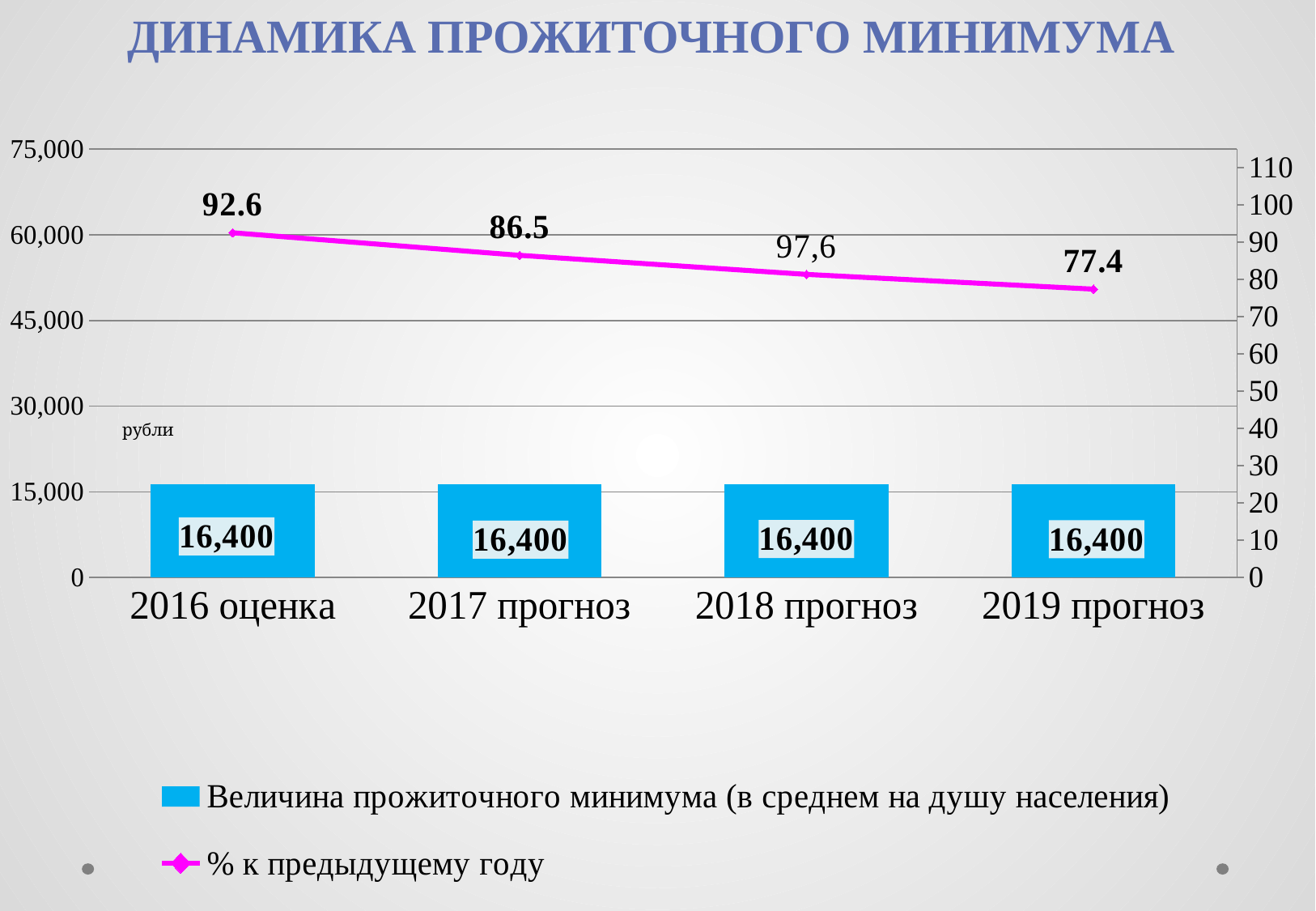
What is the value of the % к предыдущему году line for 2019 прогноз? 77.4 What kind of chart is shown on the slide? Combination bar and line chart What is the title of the chart? ДИНАМИКА ПРОЖИТОЧНОГО МИНИМУМА What is the value of the % к предыдущему году line for 2016 оценка? 92.6 Is the bar value for 2018 прогноз greater or less than 30,000? less What is the difference between the % к предыдущему году values for 2016 оценка and 2019 прогноз? 15.2 What is the value of the % к предыдущему году line for 2017 прогноз? 86.5 How many series does the legend list? 2 Which is larger on the % к предыдущему году line: 2016 оценка or 2017 прогноз? 2016 оценка Which category has the lowest value on the % к предыдущему году line? 2019 прогноз What is the value of the bar for 2016 оценка? 16,400 How many categories are shown on the x axis? 4